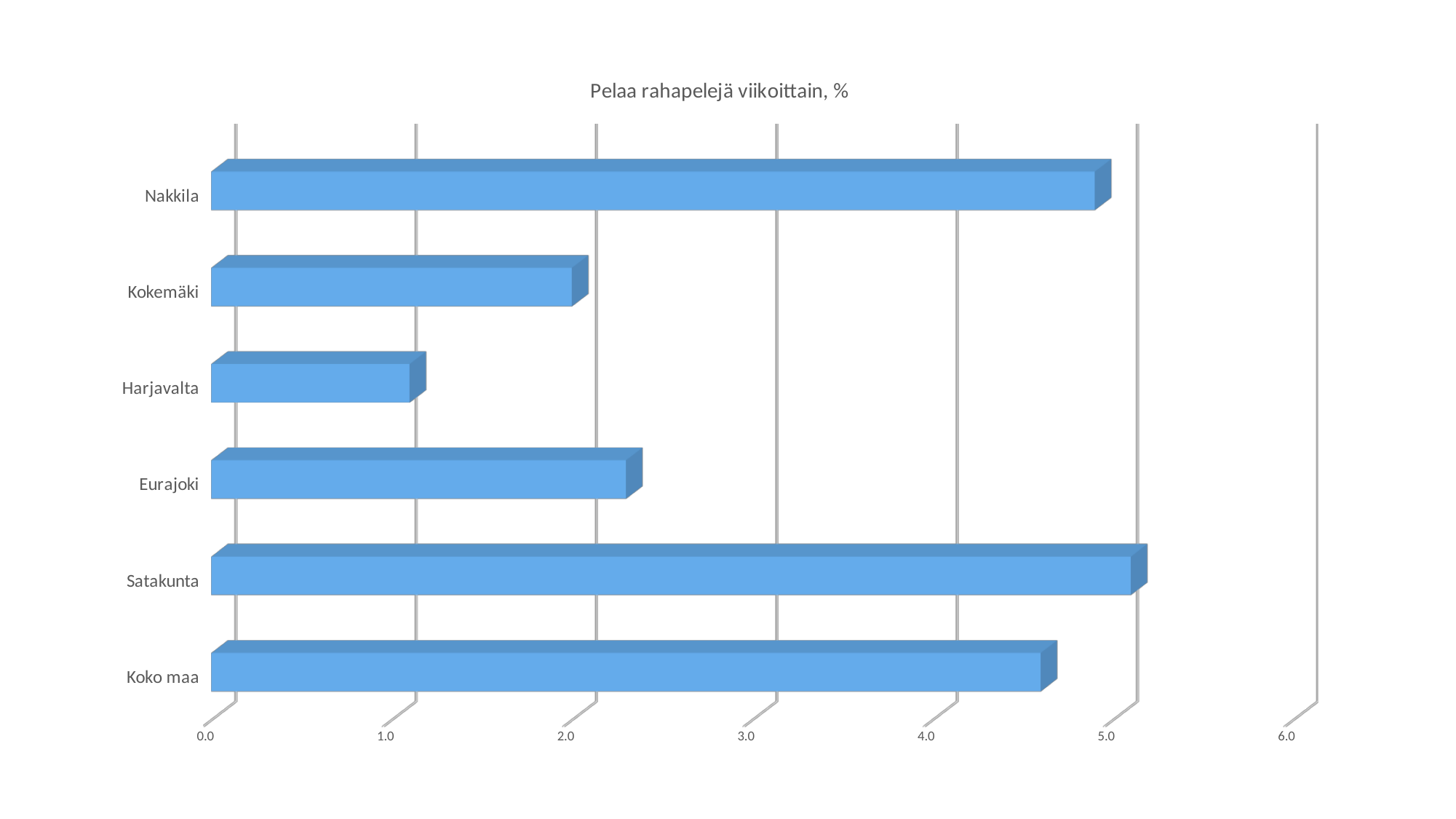
Which category has the highest value? Satakunta Is the value for Koko maa greater or less than 5.0? less Which has a larger value, Nakkila or Koko maa? Nakkila Is the value for Eurajoki greater or less than 2.0? greater How many categories are shown in the chart? 6 Which category has the lowest value? Harjavalta What is the title of the chart? Pelaa rahapelejä viikoittain, % Which has a larger value, Eurajoki or Kokemäki? Eurajoki Is the value for Nakkila greater or less than 4.0? greater What kind of chart is shown on the slide? bar chart